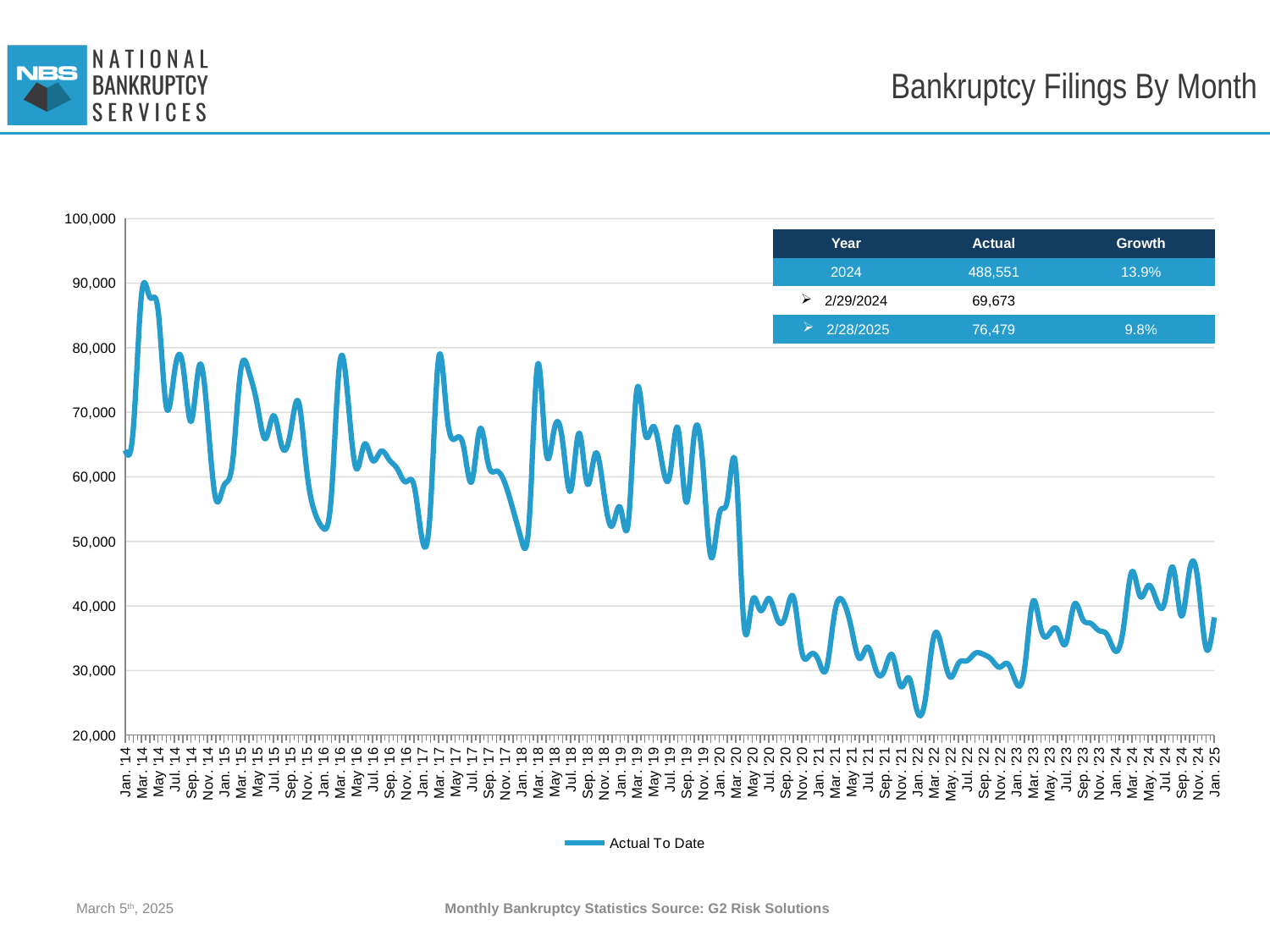
How many series does the chart legend list? 1 According to the table on the chart, what was the Actual value for 2/28/2025? 76,479 Which has the larger Actual value in the table, 2/29/2024 or 2/28/2025? 2/28/2025 What is the title of the chart on the slide? Bankruptcy Filings By Month According to the table on the chart, what was the Growth for 2024? 13.9% Is the value for Mar. '14 greater or less than 80,000? greater What is the difference between the Actual values for 2/28/2025 and 2/29/2024 in the table? 6,806 What kind of chart is shown on the slide? line chart Is the value for Jan. '22 greater or less than 30,000? less What is the name of the series shown in the chart legend? Actual To Date According to the table on the chart, what was the Growth for 2/28/2025? 9.8% According to the table on the chart, what was the Actual value for 2024? 488,551